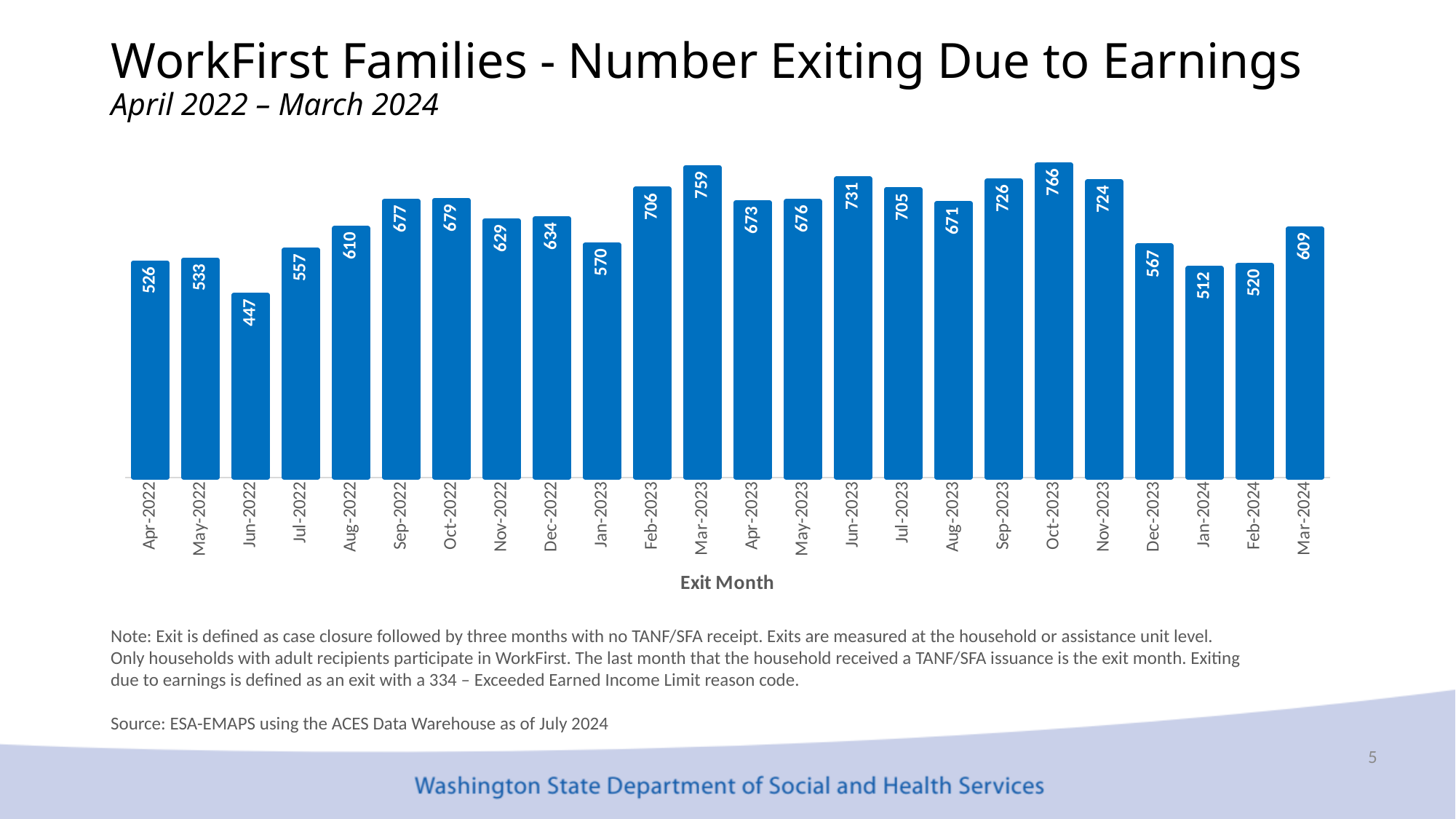
What is the value for Oct-2023? 766 Do the values rise or fall from Nov-2023 to Jan-2024? Fall How many exit months are plotted on the chart? 24 Which exit month has the lowest number of families exiting due to earnings? Jun-2022 Which is larger, the value for Mar-2023 or the value for Jun-2023? Mar-2023 Which exit month has the highest number of families exiting due to earnings? Oct-2023 How much higher is the value for Mar-2024 than for Feb-2024? 89 What is the difference between the highest value (Oct-2023) and the lowest value (Jun-2022)? 319 What is the label of the x axis? Exit Month What type of chart is shown on the slide? Bar chart What is the value for Mar-2024? 609 How many exits due to earnings are shown for Jun-2022? 447